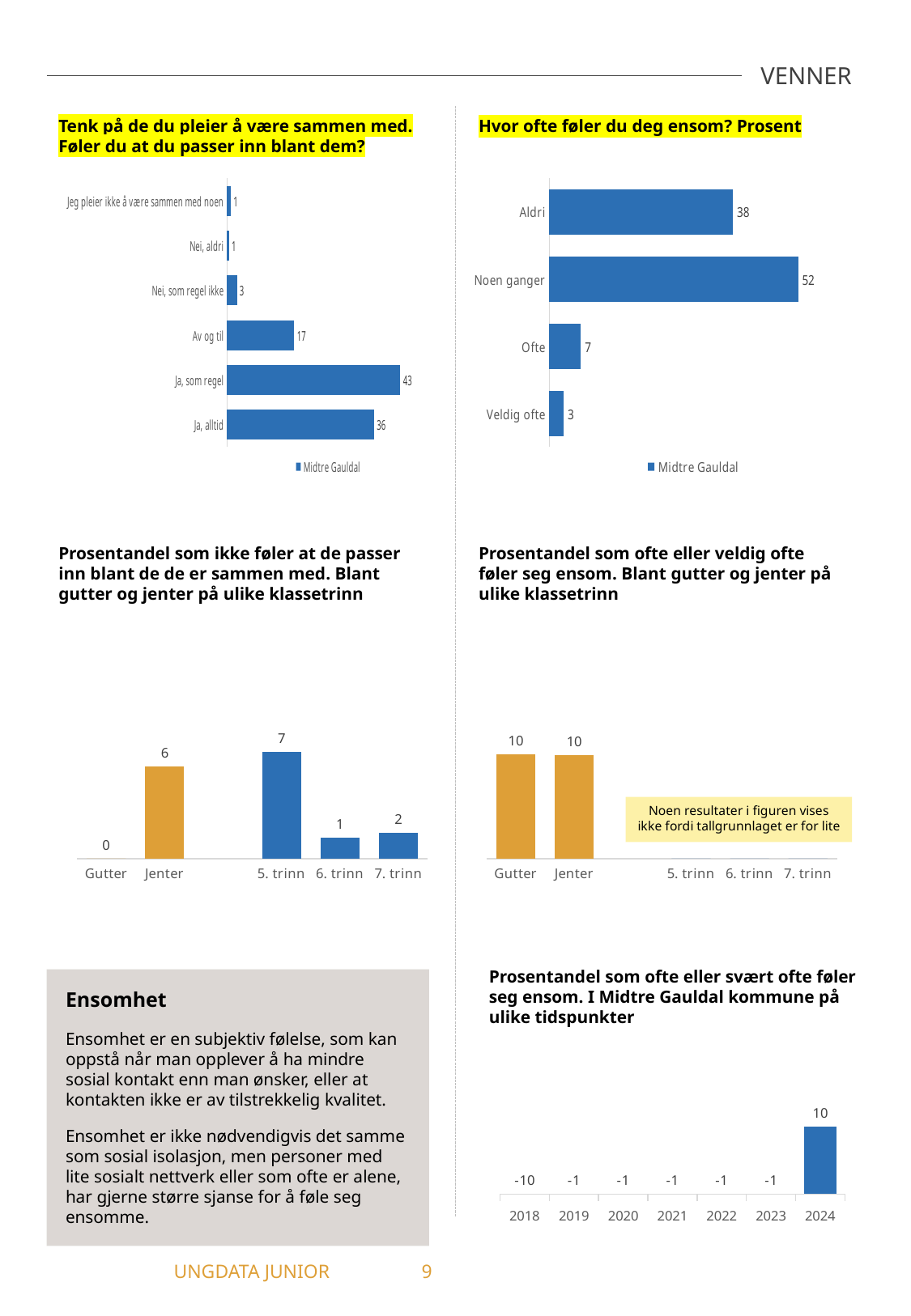
In the chart 'Prosentandel som ikke føler at de passer inn blant de de er sammen med', what is the difference between 'Jenter' and 'Gutter'? 6 In the chart 'Prosentandel som ofte eller veldig ofte føler seg ensom. Blant gutter og jenter på ulike klassetrinn', what is the value for 'Jenter'? 10 In the chart 'Tenk på de du pleier å være sammen med. Føler du at du passer inn blant dem?', which category has the highest value? Ja, som regel What kind of chart is 'Hvor ofte føler du deg ensom? Prosent'? Bar chart In the chart 'Tenk på de du pleier å være sammen med. Føler du at du passer inn blant dem?', how many categories are shown? 6 In the chart 'Hvor ofte føler du deg ensom? Prosent', what is the difference between 'Aldri' and 'Ofte'? 31 In the chart 'Prosentandel som ofte eller svært ofte føler seg ensom. I Midtre Gauldal kommune på ulike tidspunkter', what is the value for 2024? 10 In the chart 'Hvor ofte føler du deg ensom? Prosent', what is the value for 'Noen ganger'? 52 In the chart 'Tenk på de du pleier å være sammen med. Føler du at du passer inn blant dem?', what is the value for 'Av og til'? 17 In the chart 'Prosentandel som ikke føler at de passer inn blant de de er sammen med', what is the value for '5. trinn'? 7 In the chart 'Tenk på de du pleier å være sammen med. Føler du at du passer inn blant dem?', which is larger: 'Ja, som regel' or 'Ja, alltid'? Ja, som regel In the chart 'Hvor ofte føler du deg ensom? Prosent', which category has the lowest value? Veldig ofte